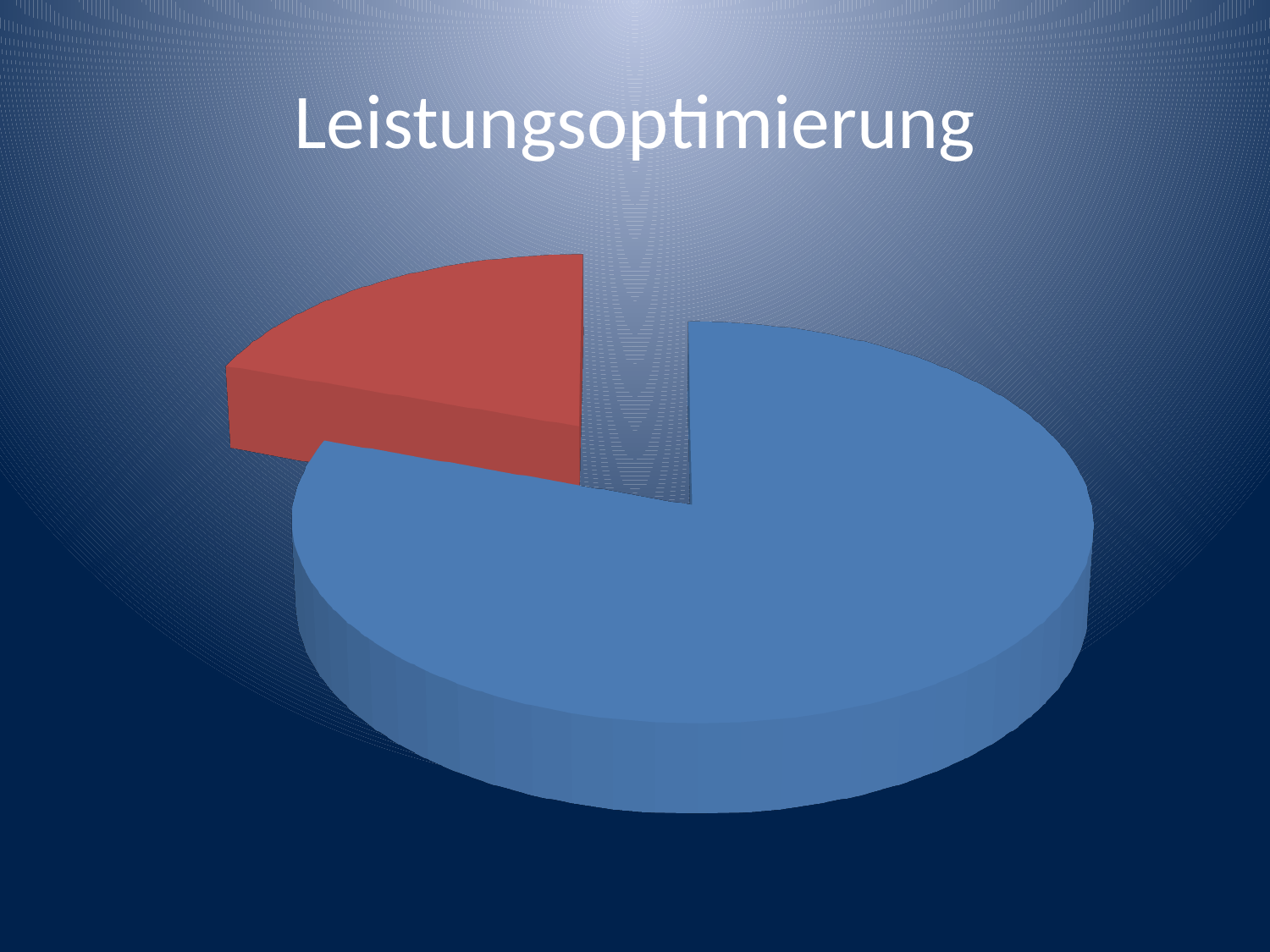
Which colour slice is the largest in the pie chart? blue Which slice is larger, the blue one or the red one? the blue one What kind of chart is shown on the slide? pie chart Which colour slice is the smallest in the pie chart? red How many slices does the pie chart have? 2 What is the title of the chart? Leistungsoptimierung Which slice is pulled out (exploded) from the pie? the red slice